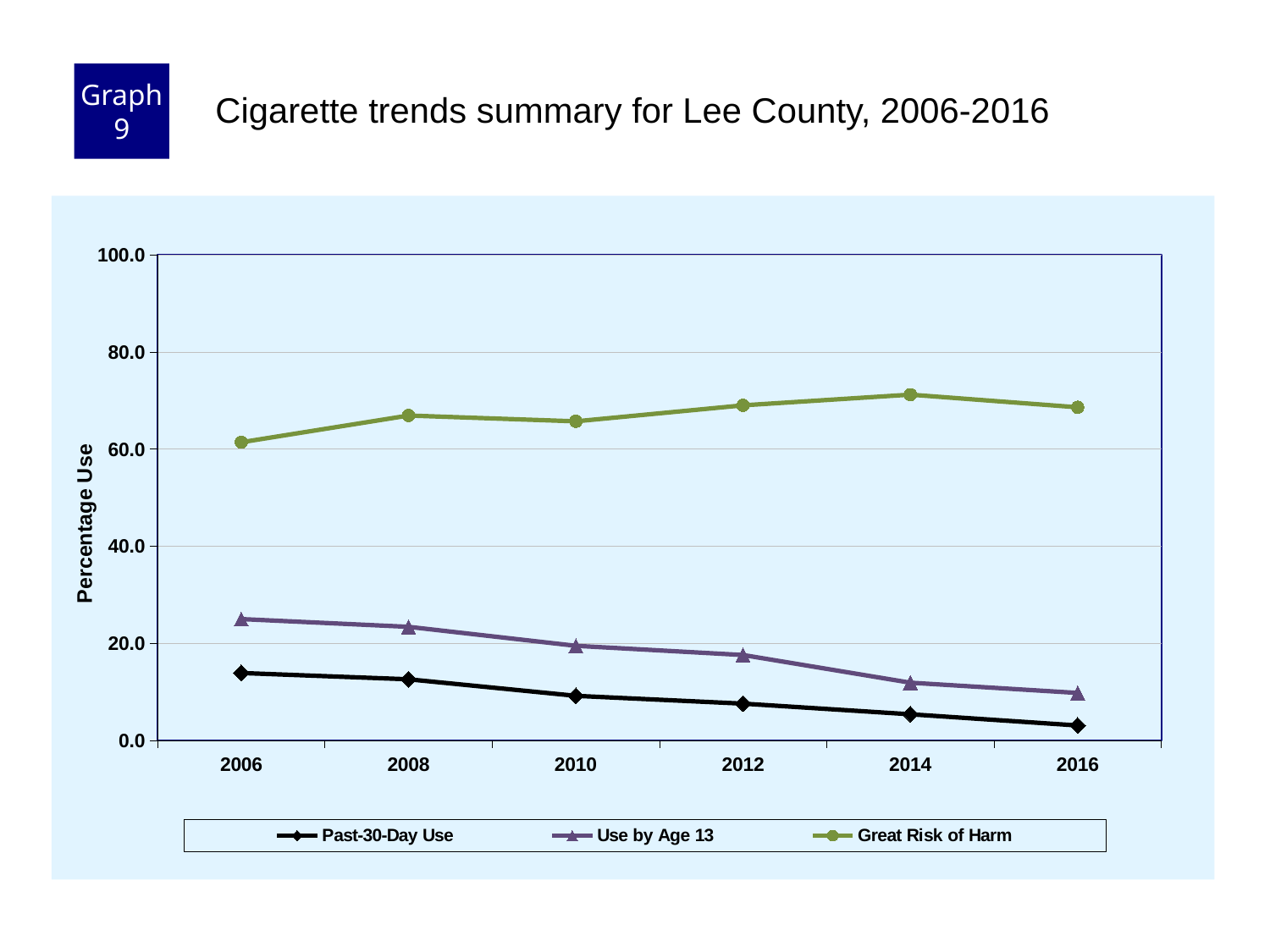
In 2006, which is larger: Use by Age 13 or Past-30-Day Use? Use by Age 13 How many series does the legend list? 3 Does the Use by Age 13 series rise or fall from 2006 to 2016? fall Is the value for Great Risk of Harm in 2014 greater or less than 60? greater In which year is Great Risk of Harm highest? 2014 How many years are plotted along the x axis? 6 What kind of chart is shown on the slide? line chart What is the label on the y axis of the chart? Percentage Use Does the Past-30-Day Use series rise or fall from 2006 to 2016? fall In which year is Past-30-Day Use lowest? 2016 Is the value for Use by Age 13 in 2006 greater or less than 20? greater Is the value for Use by Age 13 in 2016 greater or less than 20? less